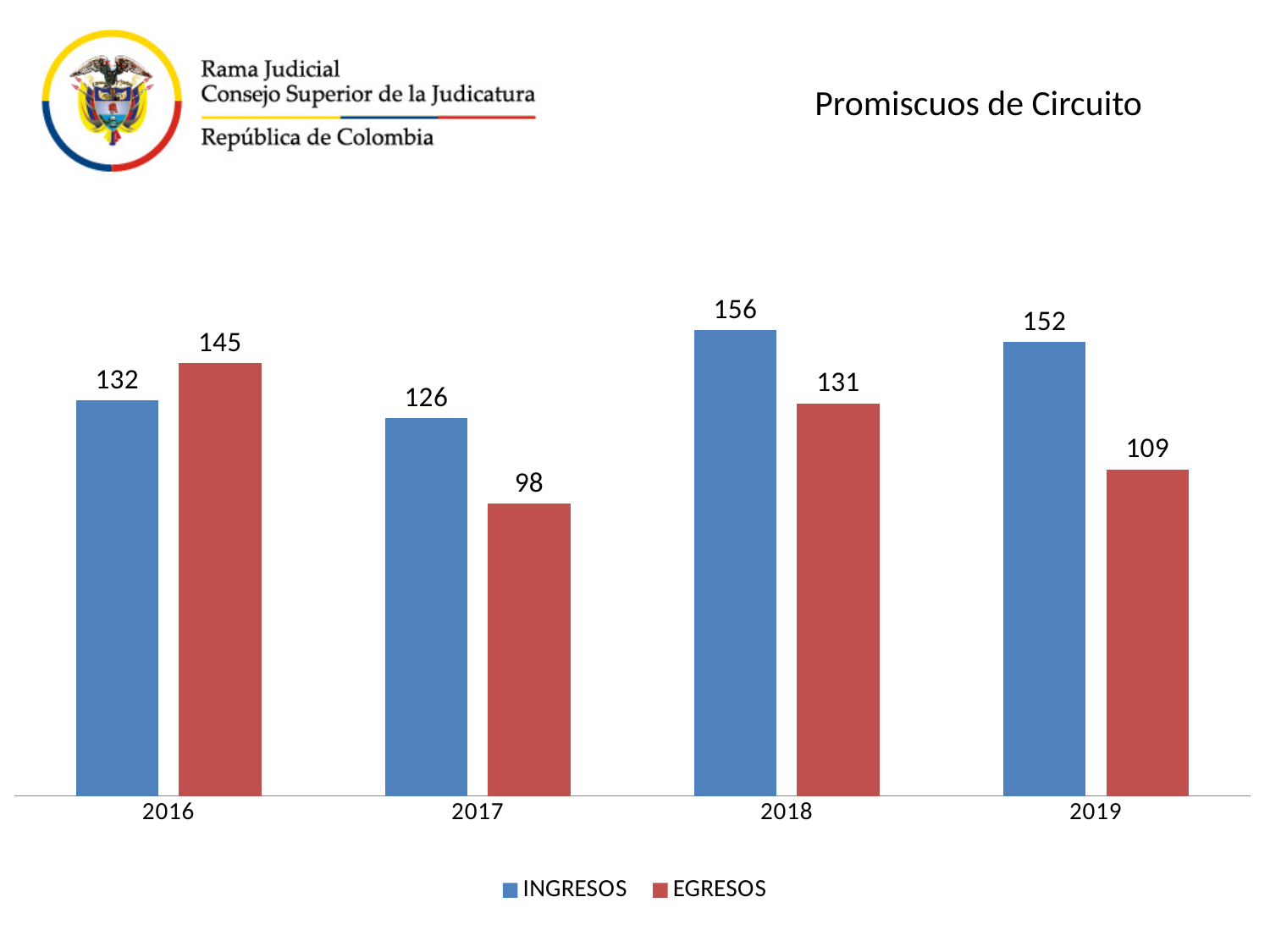
How many series does the legend list? 2 What kind of chart is shown on the slide? Bar chart What is the EGRESOS value for 2017? 98 What is the difference between INGRESOS and EGRESOS in 2019? 43 What is the EGRESOS value for 2019? 109 What is the INGRESOS value for 2016? 132 Which year has the highest INGRESOS value? 2018 How many years are shown on the x axis? 4 What is the difference between INGRESOS and EGRESOS in 2018? 25 Which year has the lowest EGRESOS value? 2017 What is the title of the chart? Promiscuos de Circuito In 2016, which is larger, INGRESOS or EGRESOS? EGRESOS